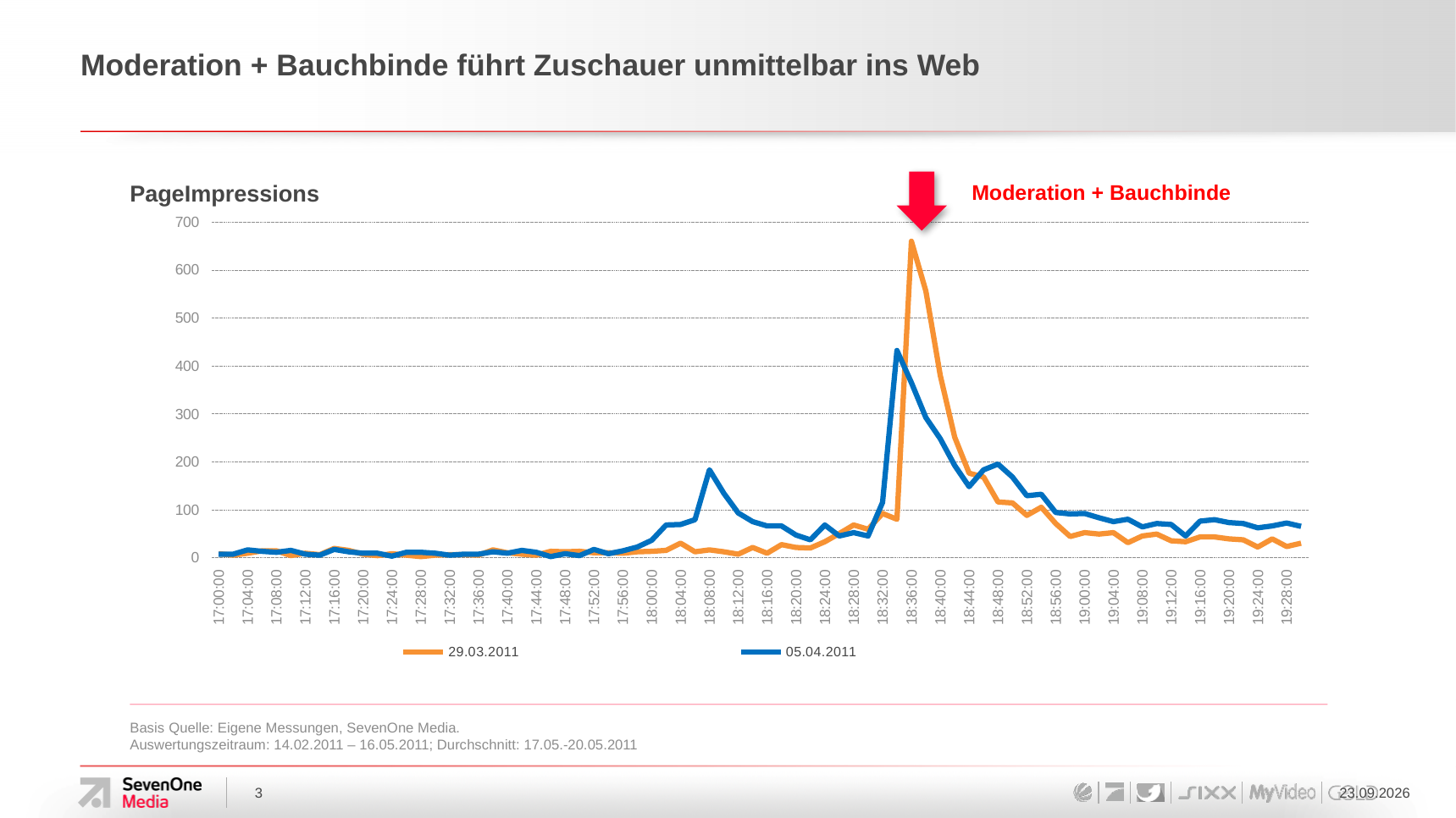
At 18:36:00, which series has the larger value, 29.03.2011 or 05.04.2011? 29.03.2011 What are the two series named in the legend? 29.03.2011 and 05.04.2011 At 18:08:00, which series has the larger value, 29.03.2011 or 05.04.2011? 05.04.2011 What kind of chart is shown on the slide? line chart What is the title of the chart? PageImpressions At which time does the 29.03.2011 series reach its peak? 18:36:00 How many series does the legend list? 2 Which series reaches the highest value on the chart? 29.03.2011 Is the peak value of the 05.04.2011 series greater or less than 300? greater Is the peak value of the 29.03.2011 series greater or less than 600? greater Do the values of the 29.03.2011 series rise or fall between 18:36:00 and 18:56:00? fall Is the value of the 29.03.2011 series at 18:08:00 greater or less than 100? less